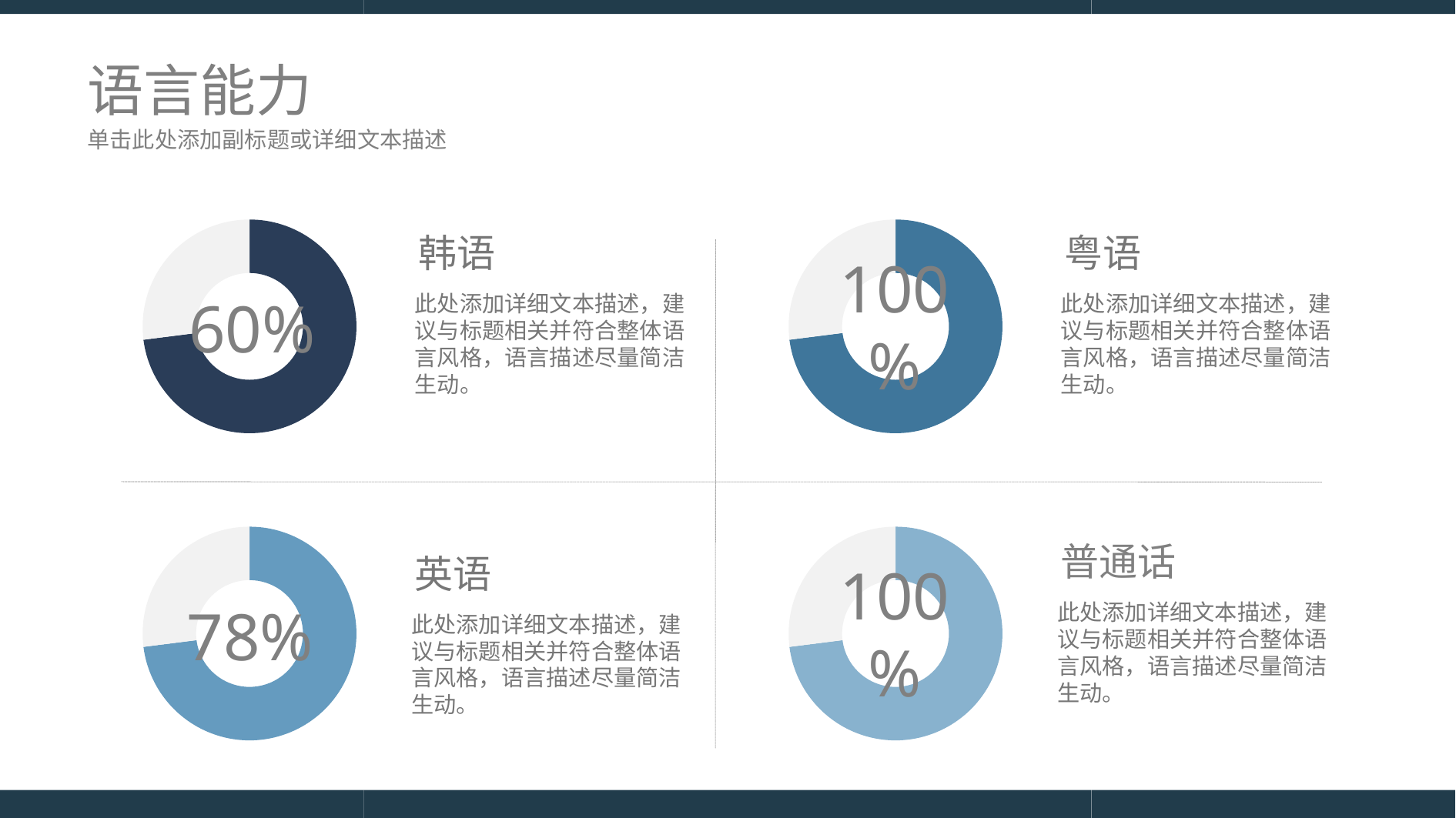
What percentage is shown in the 普通话 donut chart? 100% What is the difference between the percentages shown for 英语 and 韩语? 18% How many donut charts are on the slide? 4 Which has a higher percentage, 英语 or 韩语? 英语 What kind of chart is used to show each language's percentage? Donut (pie) chart Which language has the lowest percentage among the four donut charts? 韩语 What percentage is shown in the 英语 donut chart? 78% Is the percentage shown for 韩语 greater or less than 50%? greater What percentage is shown in the 粤语 donut chart? 100% Which language's donut chart is drawn in the darkest navy colour? 韩语 What is the title of the slide containing the four donut charts? 语言能力 What percentage is shown in the 韩语 donut chart? 60%